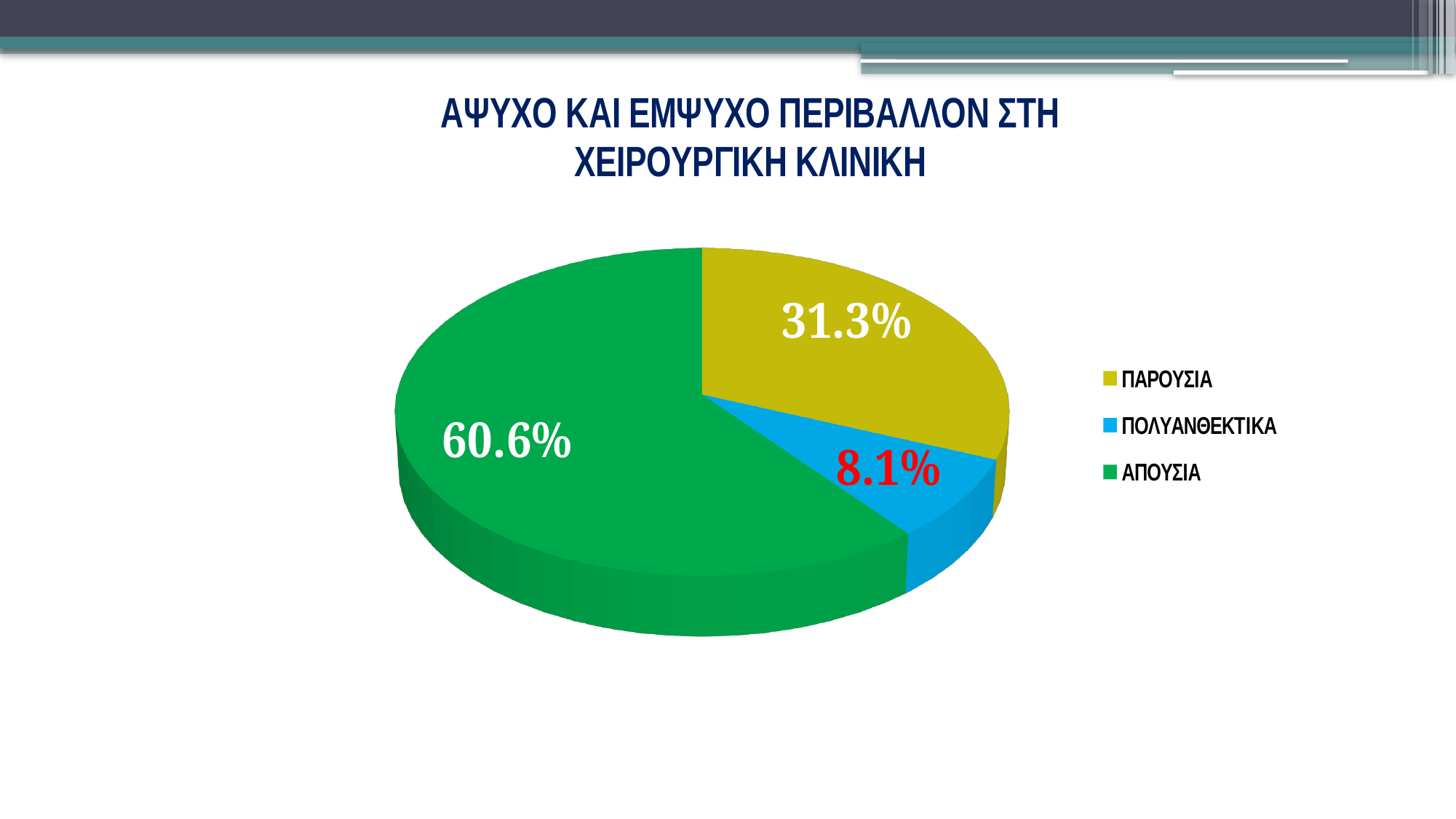
What is the value for ΑΠΟΥΣΙΑ? 60.6% What is the value for ΠΑΡΟΥΣΙΑ? 31.3% Which colour represents ΠΟΛΥΑΝΘΕΚΤΙΚΑ in the legend? blue What is the title of the chart? ΑΨΥΧΟ ΚΑΙ ΕΜΨΥΧΟ ΠΕΡΙΒΑΛΛΟΝ ΣΤΗ ΧΕΙΡΟΥΡΓΙΚΗ ΚΛΙΝΙΚΗ What is the value for ΠΟΛΥΑΝΘΕΚΤΙΚΑ? 8.1% Which is larger, the value for ΠΑΡΟΥΣΙΑ or the value for ΠΟΛΥΑΝΘΕΚΤΙΚΑ? ΠΑΡΟΥΣΙΑ What is the difference between the values for ΑΠΟΥΣΙΑ and ΠΑΡΟΥΣΙΑ? 29.3% Which category has the largest slice? ΑΠΟΥΣΙΑ How many slices does the pie chart have? 3 What kind of chart is shown on the slide? pie chart What is the difference between the values for ΠΑΡΟΥΣΙΑ and ΠΟΛΥΑΝΘΕΚΤΙΚΑ? 23.2% Which category has the smallest slice? ΠΟΛΥΑΝΘΕΚΤΙΚΑ